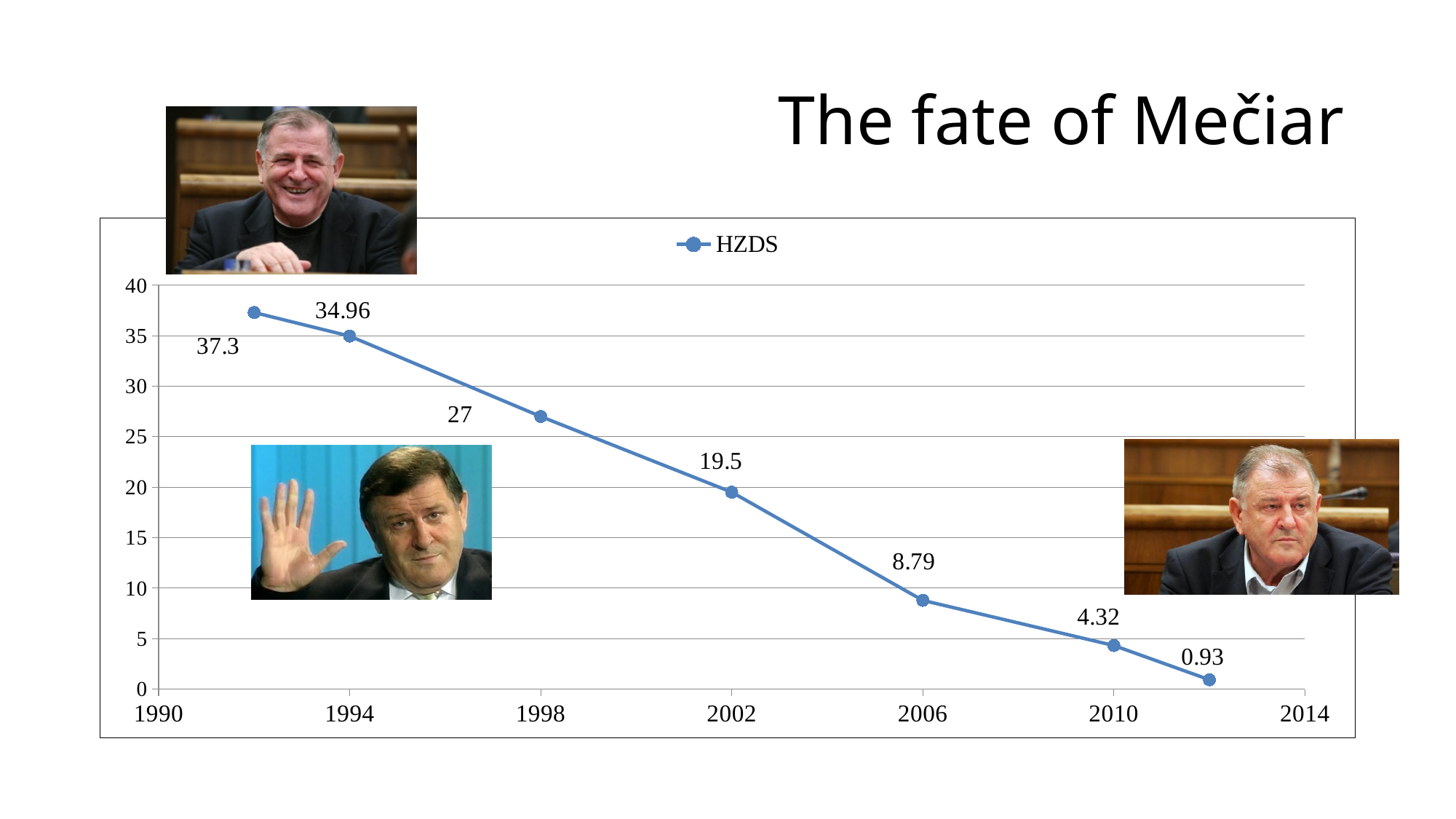
What is the HZDS value for 1998? 27 How many data points are plotted on the HZDS line? 7 What is the value of the first (leftmost) data point on the HZDS line? 37.3 What is the HZDS value for 1994? 34.96 What is the HZDS value for 2006? 8.79 What kind of chart is shown on the slide? line chart Which is larger, the HZDS value for 2006 or for 2010? 2006 What is the HZDS value for 2010? 4.32 What is the difference between the HZDS values for 1998 and 2002? 7.5 What is the value of the last (rightmost) data point on the HZDS line? 0.93 Do the HZDS values rise or fall from left to right along the x axis? fall What is the HZDS value for 2002? 19.5